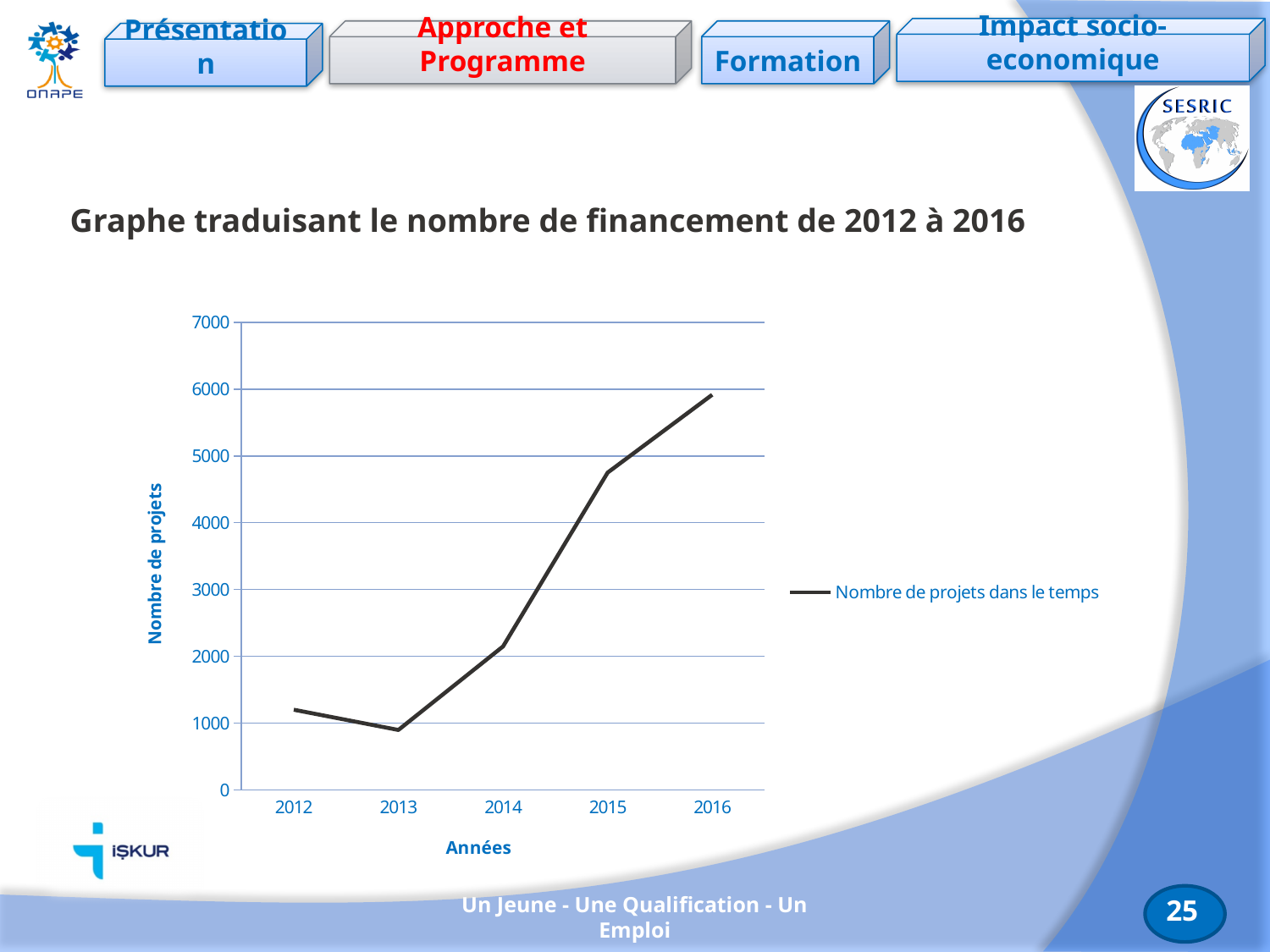
What kind of chart is shown on the slide? line chart Do the values rise or fall from 2013 to 2016? rise Which year has the highest number of projects? 2016 How many series does the legend list? 1 Which is larger, the value for 2014 or the value for 2015? 2015 What is the label of the y axis? Nombre de projets Is the value for 2012 greater or less than 2000? less Which year has the lowest number of projects? 2013 How many years are plotted on the x axis? 5 Is the value for 2016 greater or less than 5000? greater Is the value for 2014 greater or less than 3000? less